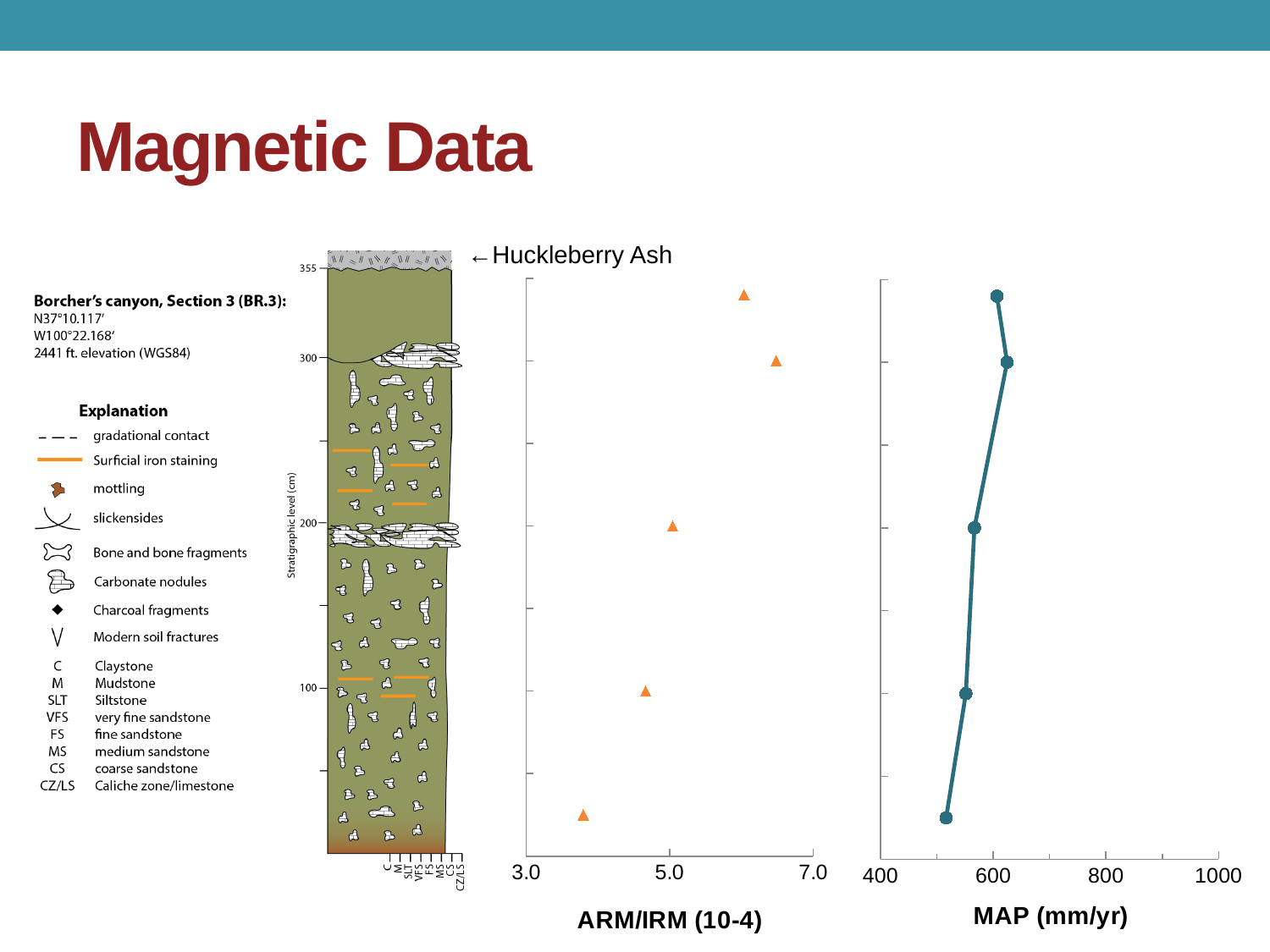
On the ARM/IRM chart, is the value of the lowest (bottom) point greater or less than 5.0? less What kind of chart is the ARM/IRM chart? scatter chart What kind of chart is the MAP (mm/yr) chart? line chart What is the x-axis label of the middle chart with orange triangles? ARM/IRM (10-4) On the ARM/IRM chart, is the value of the topmost point greater or less than 5.0? greater On the MAP (mm/yr) chart, do the values generally rise or fall going up the stratigraphic section from bottom to top? rise On the MAP (mm/yr) chart, is the value of the lowest (bottom) point greater or less than 600? less On the ARM/IRM chart, which point has the lowest value: the topmost point or the bottom point? the bottom point On the MAP (mm/yr) chart, how many data points are plotted? 5 What is the x-axis label of the right-hand chart? MAP (mm/yr) On the ARM/IRM chart, how many data points are plotted? 5